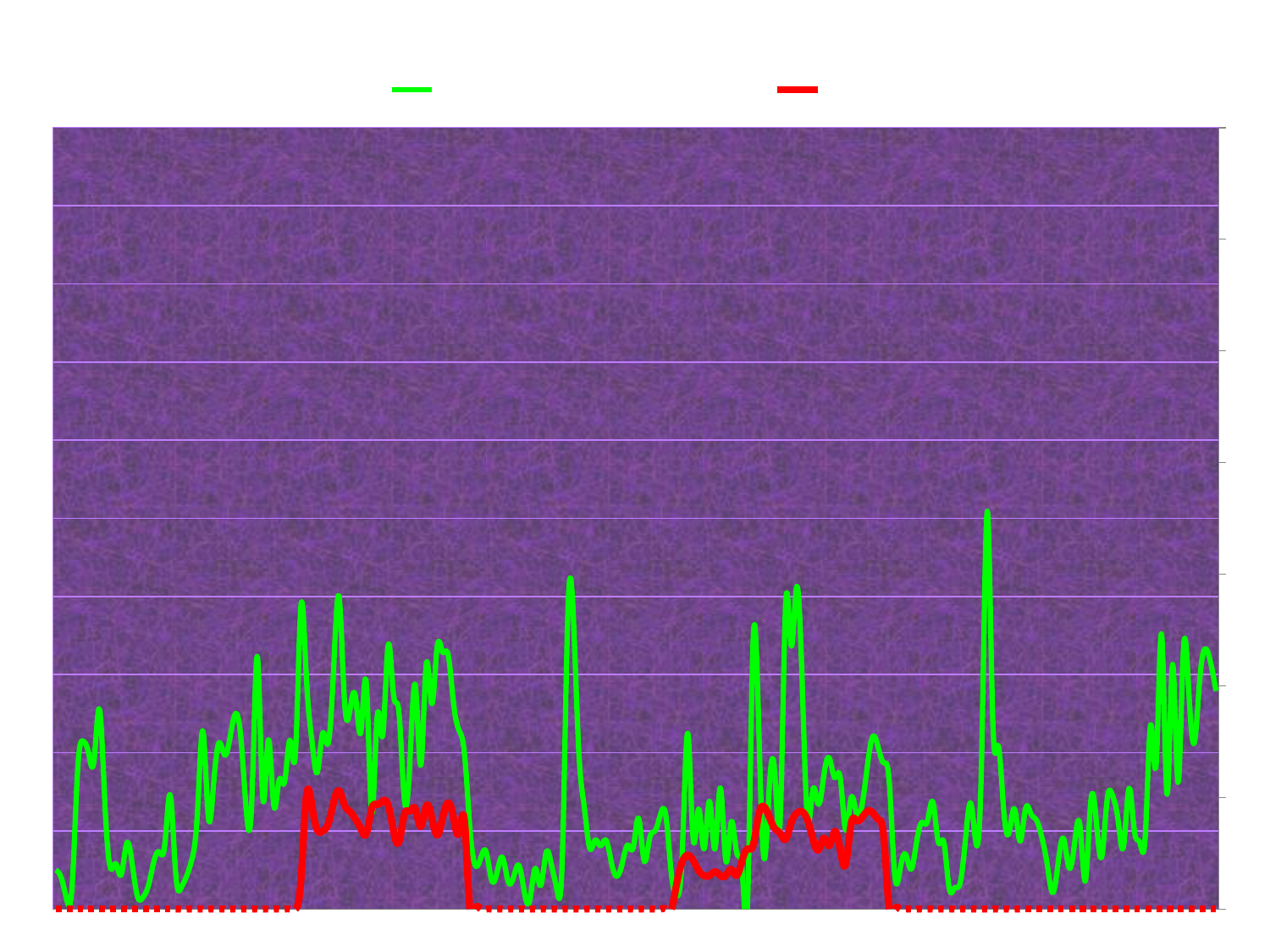
Which series stays closest to the bottom of the chart for most of the x axis? red What colour is the background of the plot area? purple What colours are the two lines plotted on the chart? green and red What kind of chart is shown on the slide? line chart Which series reaches higher values on the chart, the green line or the red line? green How many series does the legend list? 2